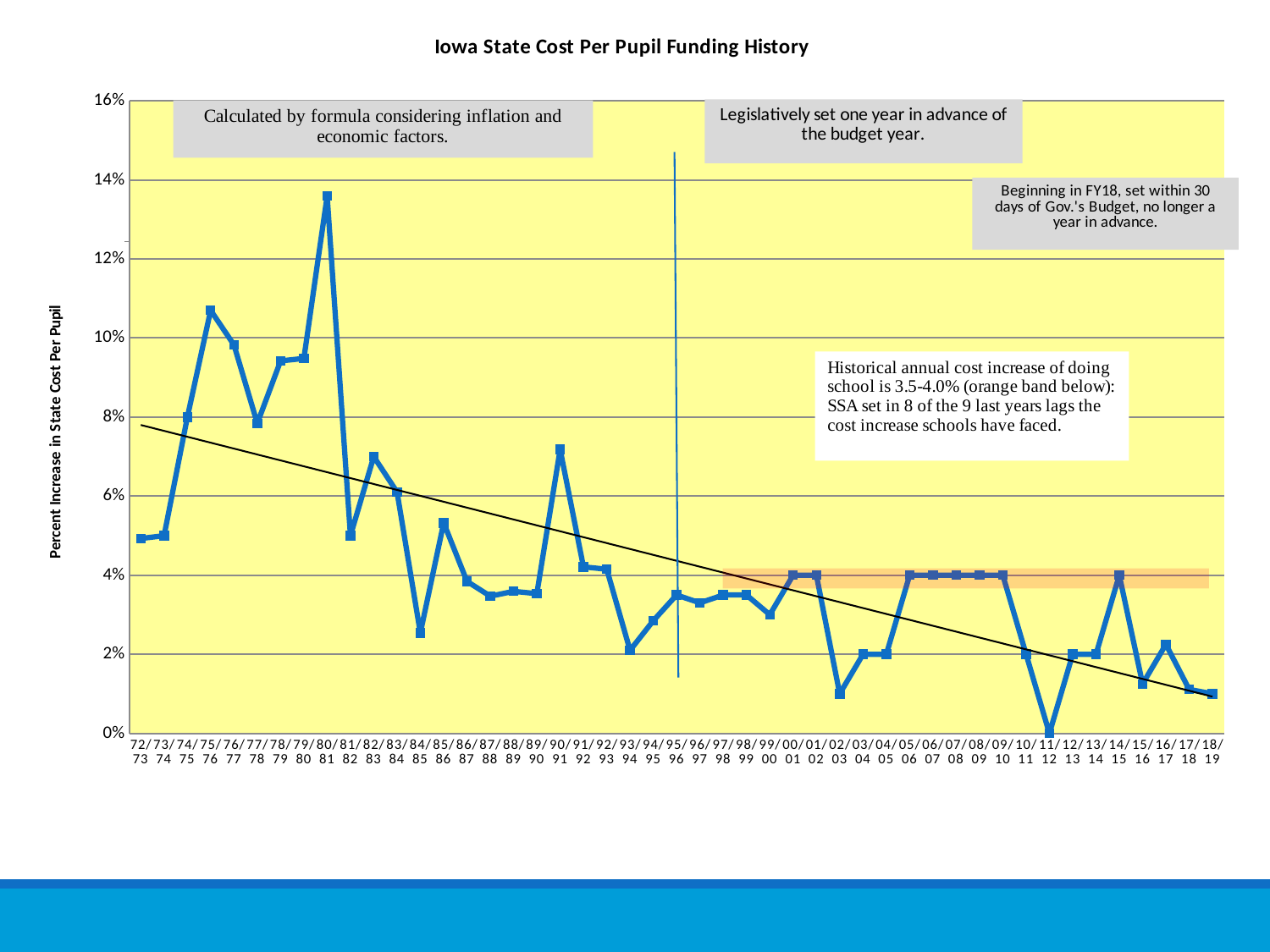
Is the value for 90/91 greater or less than 6%? greater Is the value for 84/85 greater or less than 4%? less What is the title of the chart? Iowa State Cost Per Pupil Funding History Which year has the lowest percent increase in state cost per pupil? 11/12 What is the percent increase for 11/12? 0% Overall, do the percent increases rise or fall from 72/73 to 18/19? Fall What is the label on the vertical axis of the chart? Percent Increase in State Cost Per Pupil What is the percent increase for 14/15? 4% Which year has the highest percent increase in state cost per pupil? 80/81 Is the value for 75/76 greater or less than 10%? greater What type of chart is shown on the slide? Line chart Which year has a larger percent increase, 80/81 or 75/76? 80/81